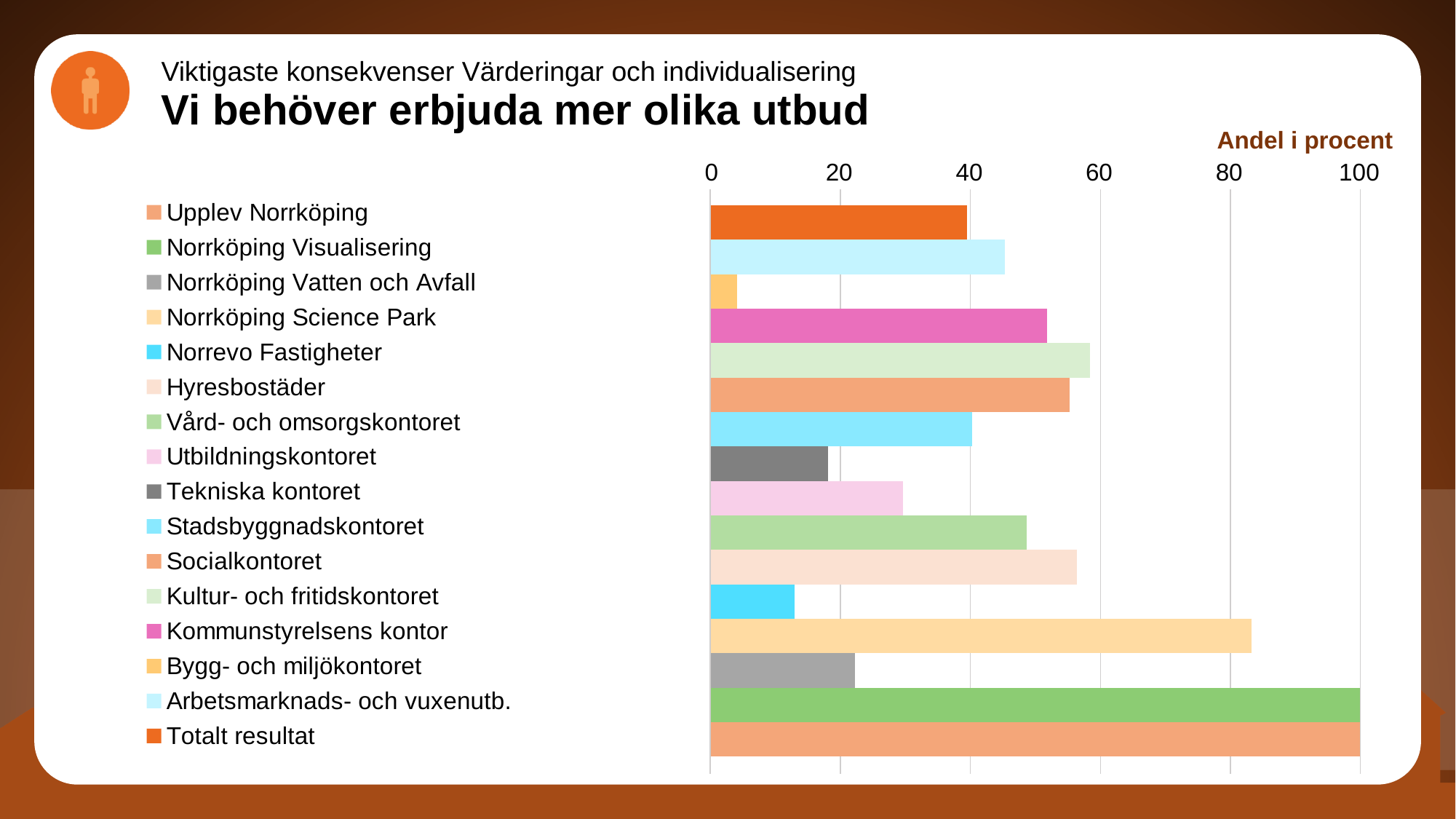
Which category has the lowest value? Bygg- och miljökontoret What is the value for Norrköping Visualisering? 100 Which is larger, the value for Utbildningskontoret or the value for Vård- och omsorgskontoret? Vård- och omsorgskontoret What kind of chart is shown on the slide? bar chart Is the value for Tekniska kontoret greater or less than 20? less Is the value for Kultur- och fritidskontoret greater or less than 40? greater What is the value for Upplev Norrköping? 100 What label is shown above the horizontal axis of the chart? Andel i procent How many entries does the legend list? 16 How many bars are plotted in the chart? 16 Which is larger, the value for Norrevo Fastigheter or the value for Hyresbostäder? Hyresbostäder Is the value for Norrköping Science Park greater or less than 80? greater